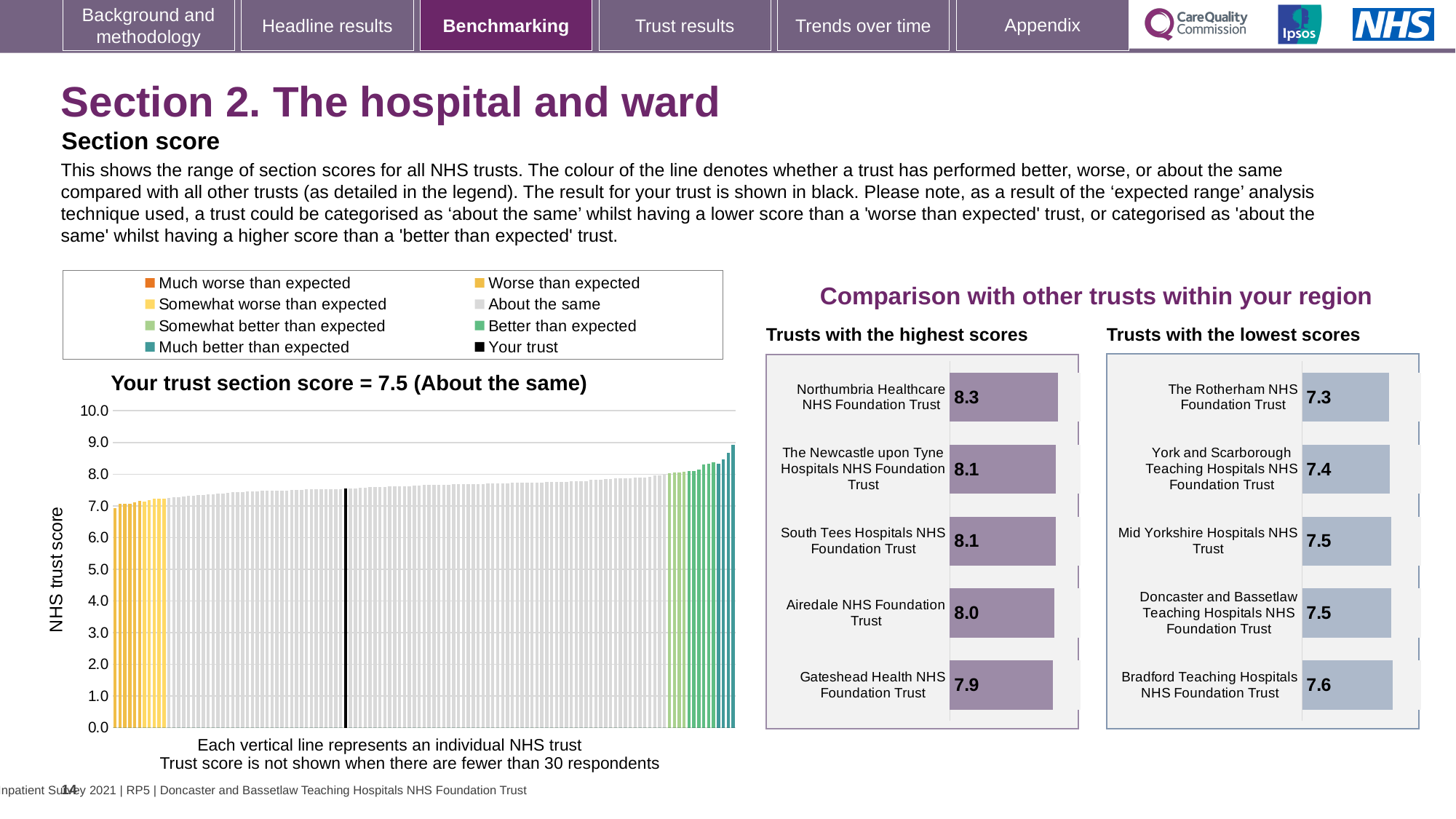
What kind of chart is the 'Your trust section score' chart on the left of the slide? bar chart In the 'Trusts with the lowest scores' chart, which has the higher score: Bradford Teaching Hospitals NHS Foundation Trust or York and Scarborough Teaching Hospitals NHS Foundation Trust? Bradford Teaching Hospitals NHS Foundation Trust What is the y-axis label of the left-hand chart? NHS trust score In the 'Trusts with the highest scores' chart, what is the difference between the scores of Northumbria Healthcare NHS Foundation Trust and Gateshead Health NHS Foundation Trust? 0.4 According to the title of the left-hand chart, what is your trust's section score? 7.5 How many entries does the legend above the left-hand chart list? 8 In the 'Trusts with the lowest scores' chart, what is the score for The Rotherham NHS Foundation Trust? 7.3 In the 'Trusts with the lowest scores' chart, which trust has the lowest score? The Rotherham NHS Foundation Trust In the 'Trusts with the highest scores' chart, what is the score for Northumbria Healthcare NHS Foundation Trust? 8.3 How many trusts are shown in the 'Trusts with the highest scores' chart? 5 In the 'Trusts with the highest scores' chart, which trust has the highest score? Northumbria Healthcare NHS Foundation Trust In the 'Trusts with the lowest scores' chart, what is the score for Doncaster and Bassetlaw Teaching Hospitals NHS Foundation Trust? 7.5